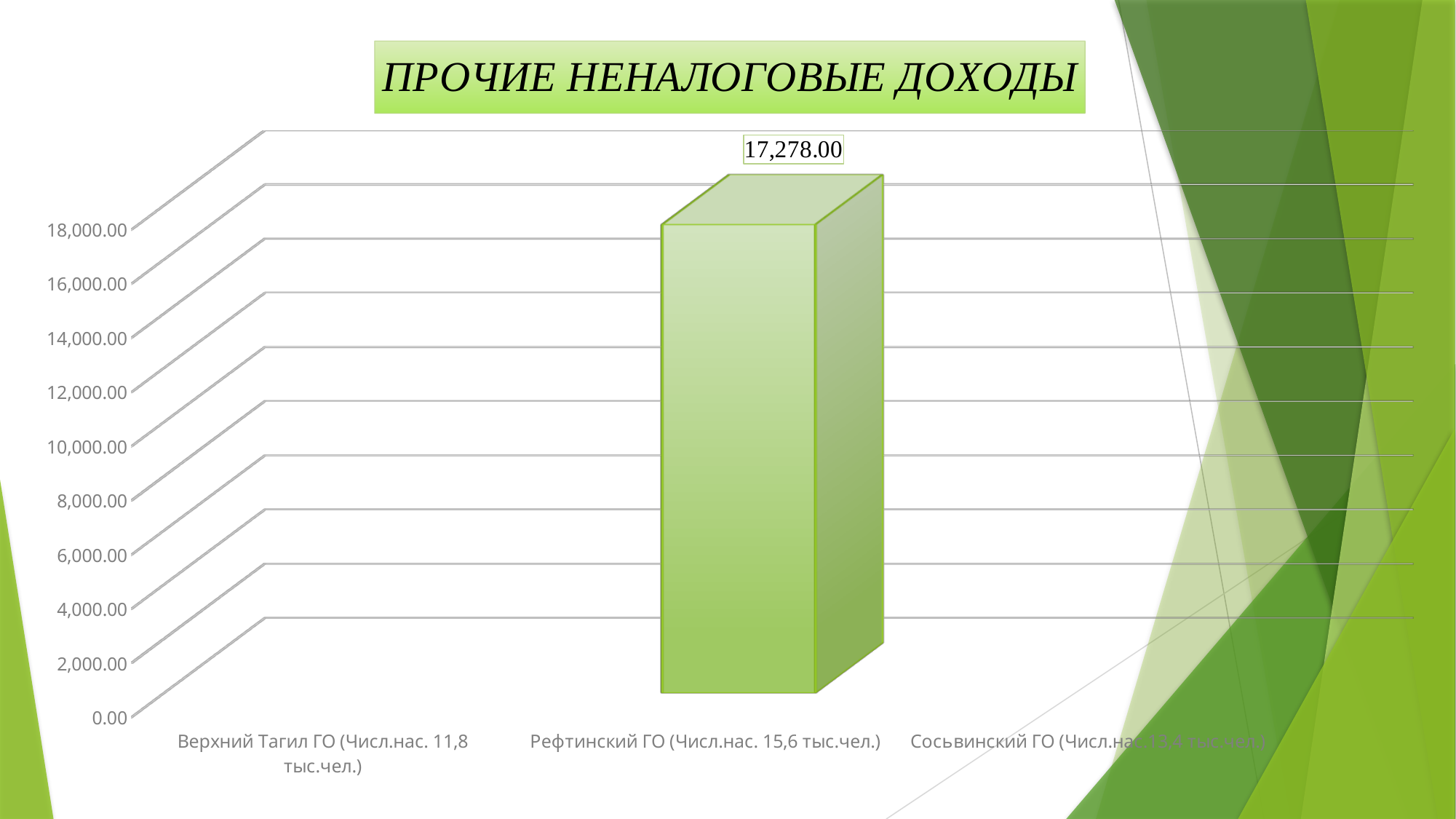
Which category has the highest value? Рефтинский ГО (Числ.нас. 15,6 тыс.чел.) What is the value for Рефтинский ГО (Числ.нас. 15,6 тыс.чел.)? 17,278.00 Is the value for Рефтинский ГО greater or less than 16,000.00? greater What is the title of the chart? ПРОЧИЕ НЕНАЛОГОВЫЕ ДОХОДЫ What is the highest value labelled on the vertical axis? 18,000.00 Is the value for Рефтинский ГО greater or less than 18,000.00? less How many bars are plotted on the chart? 1 How many categories are shown on the x axis? 3 Which category's bar is labelled 17,278.00? Рефтинский ГО (Числ.нас. 15,6 тыс.чел.) What kind of chart is shown on the slide? bar chart